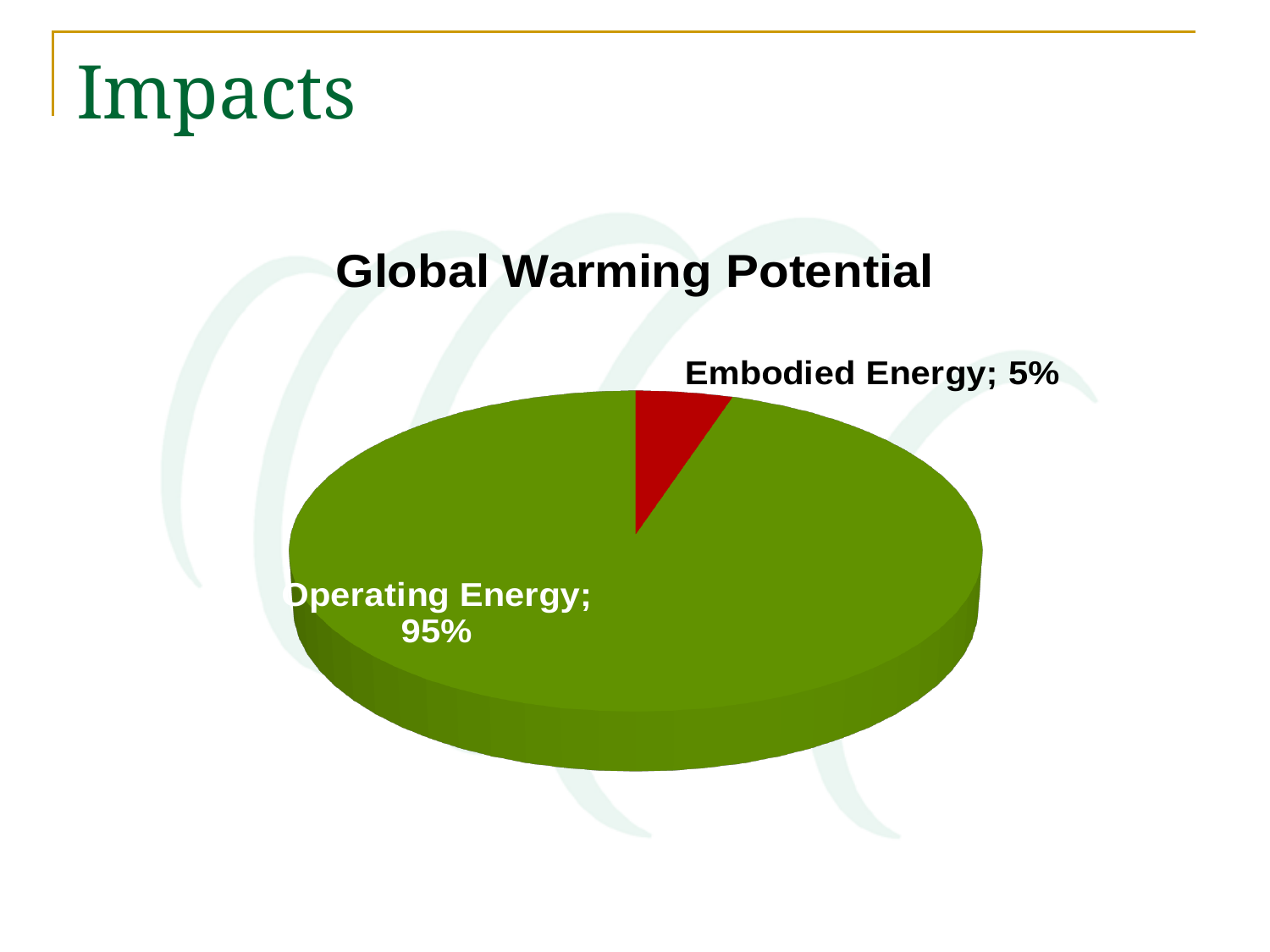
What is the difference in percentage points between Operating Energy and Embodied Energy? 90 percentage points What kind of chart is shown on the slide? Pie chart What share of the pie does Embodied Energy represent? 5% Which is larger, the Embodied Energy slice or the Operating Energy slice? Operating Energy How many slices does the pie chart have? 2 What colour is the Embodied Energy slice? Red Which category has the smallest slice of the pie? Embodied Energy What share of the pie does Operating Energy represent? 95% What is the total of the two slices shown in the pie chart? 100% Which category has the largest slice of the pie? Operating Energy What is the title of the chart? Global Warming Potential